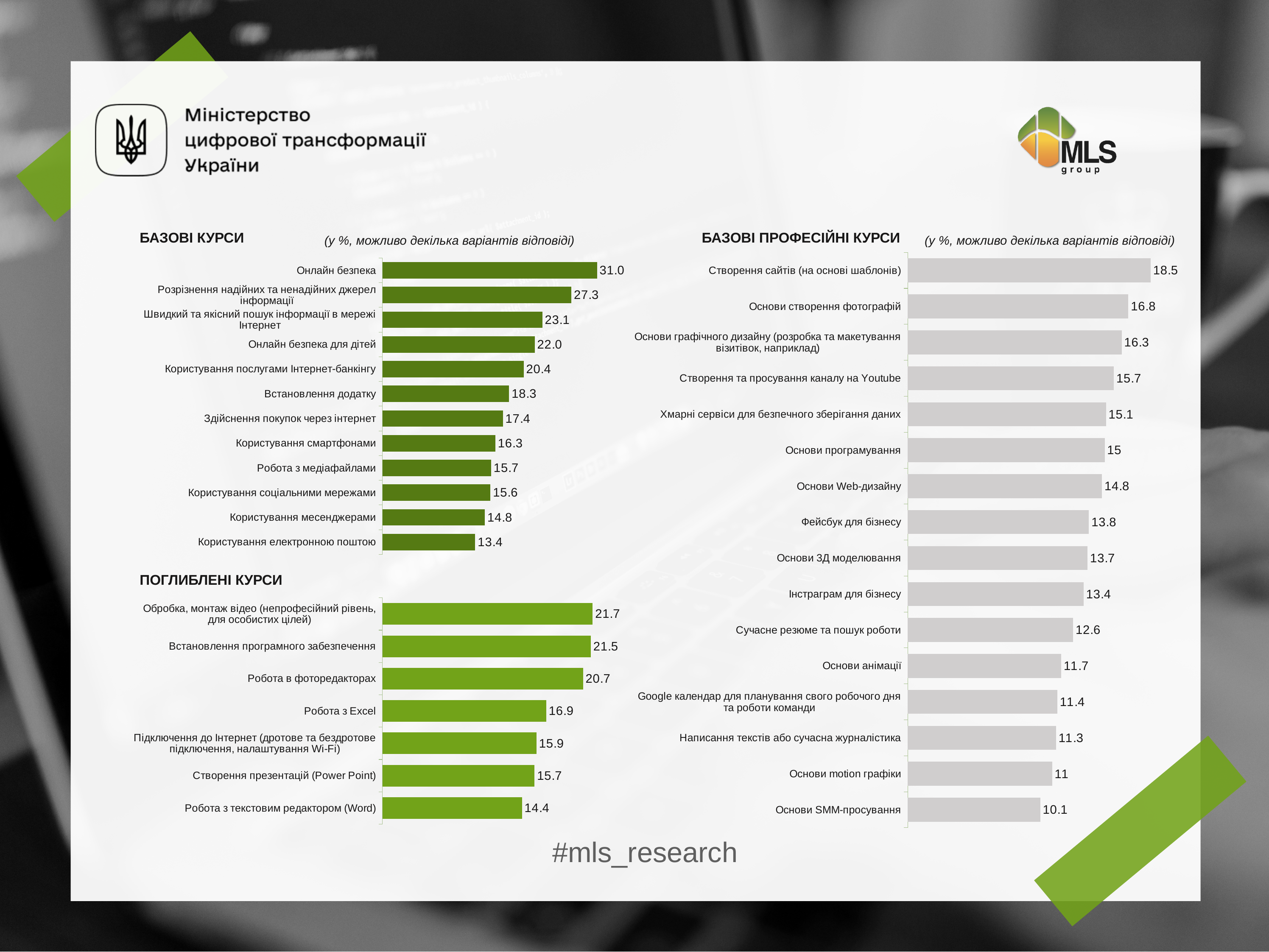
How many categories are shown in the "БАЗОВІ ПРОФЕСІЙНІ КУРСИ" chart? 16 In the "ПОГЛИБЛЕНІ КУРСИ" chart, what is the value for "Робота з Excel"? 16.9 In the "БАЗОВІ КУРСИ" chart, which category has the lowest value? Користування електронною поштою What type of chart is the "БАЗОВІ ПРОФЕСІЙНІ КУРСИ" chart? Bar chart In the "БАЗОВІ КУРСИ" chart, what is the value for "Онлайн безпека"? 31.0 In the "БАЗОВІ ПРОФЕСІЙНІ КУРСИ" chart, which is larger: "Фейсбук для бізнесу" or "Інстраграм для бізнесу"? Фейсбук для бізнесу How many categories are shown in the "ПОГЛИБЛЕНІ КУРСИ" chart? 7 In the "ПОГЛИБЛЕНІ КУРСИ" chart, which category has the highest value? Обробка, монтаж відео (непрофесійний рівень, для особистих цілей) In the "БАЗОВІ КУРСИ" chart, what is the difference between "Онлайн безпека" and "Онлайн безпека для дітей"? 9.0 How many categories are shown in the "БАЗОВІ КУРСИ" chart? 12 In the "БАЗОВІ ПРОФЕСІЙНІ КУРСИ" chart, which category has the highest value? Створення сайтів (на основі шаблонів) In the "БАЗОВІ ПРОФЕСІЙНІ КУРСИ" chart, what is the value for "Основи програмування"? 15